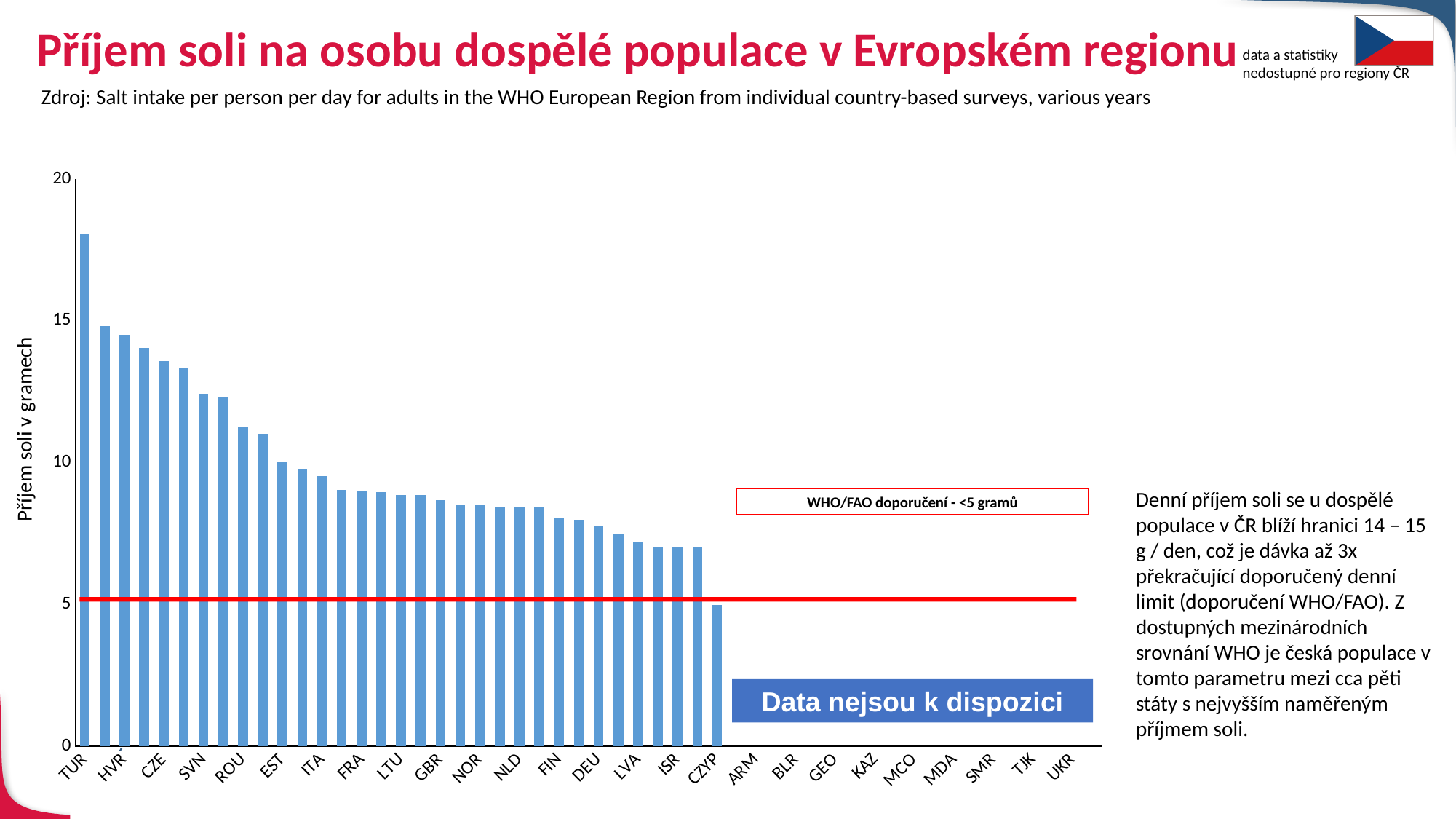
Is the value for TUR greater or less than 15? greater Is the value for ISR greater or less than 5? greater Do the bar values rise or fall from left to right along the x axis? fall Which country has the highest salt intake in the chart? TUR Which has a larger value, TUR or CZYP? TUR Is the value for DEU greater or less than 10? less Among the countries with data shown, which has the lowest salt intake? CZYP What value does the red horizontal line in the chart mark? 5 What kind of chart is shown on the slide? bar chart Which has a larger value, FRA or ROU? ROU